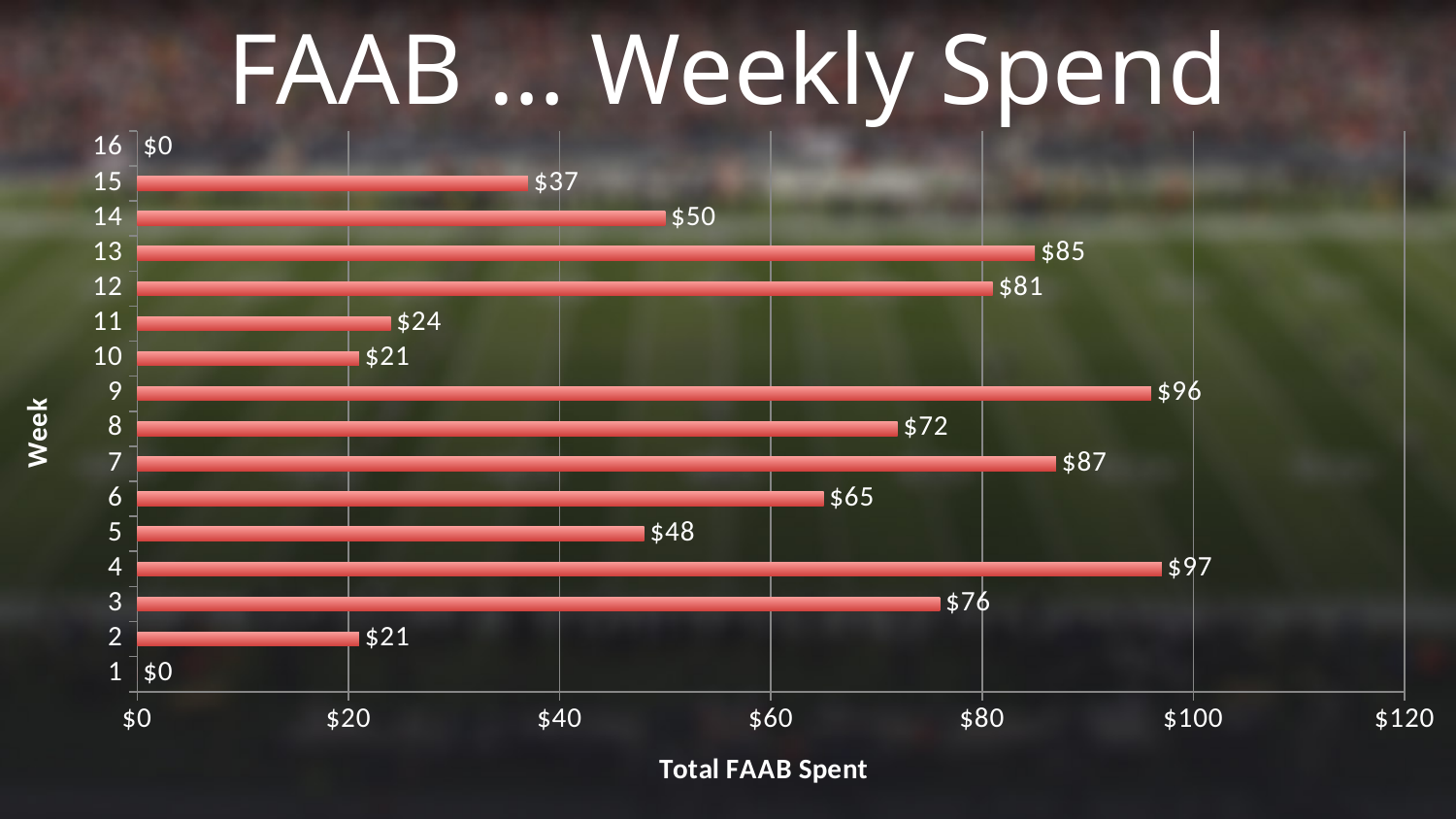
Which weeks have the lowest total FAAB spent? Weeks 1 and 16 Which week had more FAAB spent, week 3 or week 6? Week 3 What is the total FAAB spent in week 9? $96 What is the total FAAB spent in week 13? $85 How many weeks are shown on the chart? 16 What is the difference in FAAB spent between week 7 and week 8? $15 Is the value for week 12 greater or less than $80? greater What is the label of the horizontal axis? Total FAAB Spent What kind of chart is shown on the slide? Bar chart Which week has the highest total FAAB spent? Week 4 What is the total FAAB spent in week 5? $48 What is the title of the chart? FAAB ... Weekly Spend